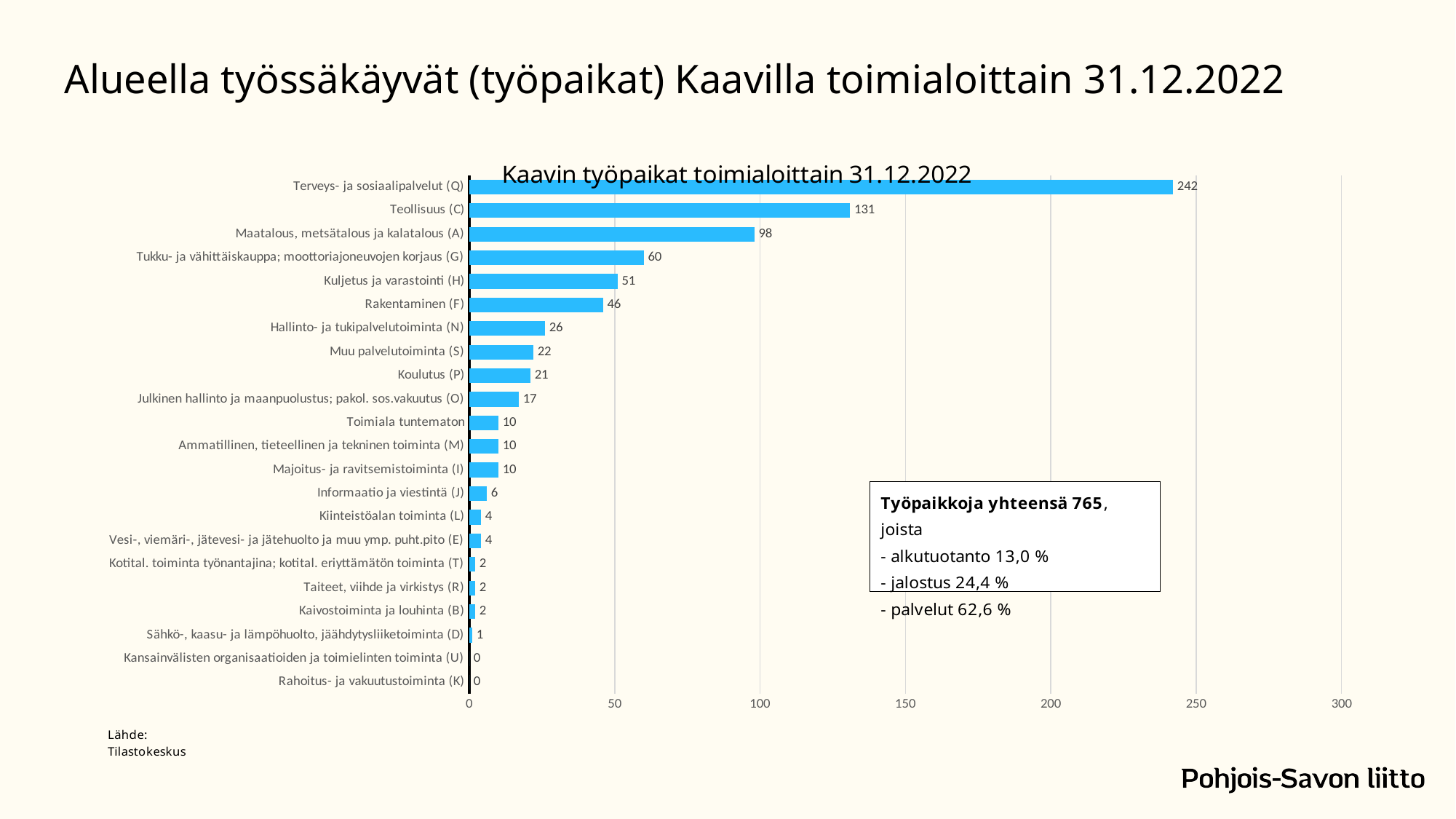
Is the value for Tukku- ja vähittäiskauppa; moottoriajoneuvojen korjaus (G) greater or less than 50? greater What is the title of the chart? Kaavin työpaikat toimialoittain 31.12.2022 What is the value for Koulutus (P)? 21 What is the difference between Teollisuus (C) and Maatalous, metsätalous ja kalatalous (A)? 33 What is the value for Teollisuus (C)? 131 What is the value for Terveys- ja sosiaalipalvelut (Q)? 242 What is the value for Kuljetus ja varastointi (H)? 51 Which is larger, Rakentaminen (F) or Hallinto- ja tukipalvelutoiminta (N)? Rakentaminen (F) What kind of chart is shown on the slide? bar chart How many categories are shown in the chart? 22 What is the value for Informaatio ja viestintä (J)? 6 Which category has the highest value? Terveys- ja sosiaalipalvelut (Q)